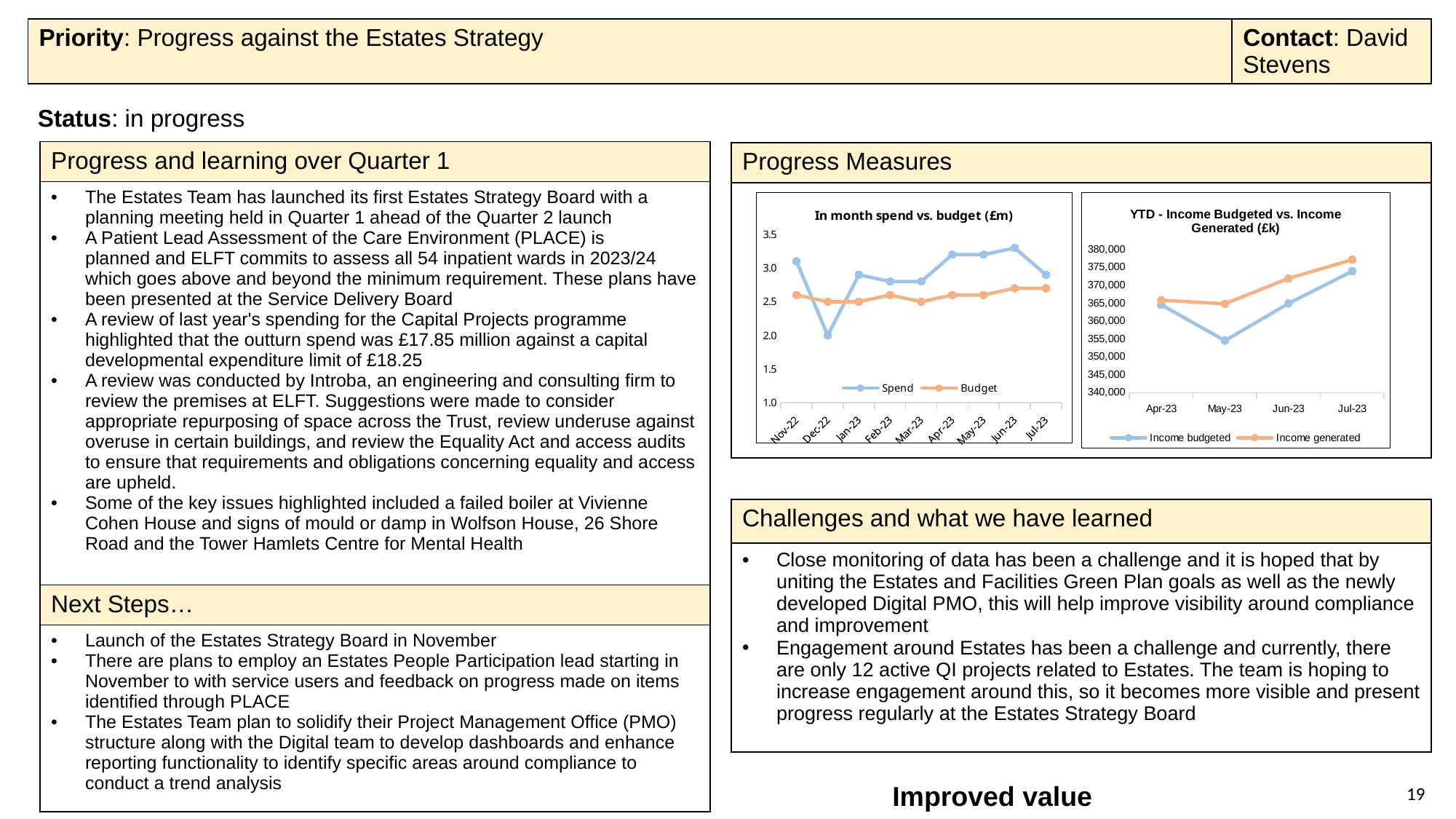
In the 'YTD - Income Budgeted vs. Income Generated (£k)' chart, is the Income budgeted value for May-23 greater or less than 360,000? less What are the two legend entries in the 'YTD - Income Budgeted vs. Income Generated (£k)' chart? Income budgeted and Income generated In the 'YTD - Income Budgeted vs. Income Generated (£k)' chart, which is larger in Jul-23, Income budgeted or Income generated? Income generated In the 'YTD - Income Budgeted vs. Income Generated (£k)' chart, how many months are plotted? 4 In the 'In month spend vs. budget (£m)' chart, which month has the lowest Spend value? Dec-22 In the 'In month spend vs. budget (£m)' chart, is the Spend value for Jun-23 greater or less than 3.0? greater In the 'In month spend vs. budget (£m)' chart, how many series does the legend list? 2 What kind of chart is the 'In month spend vs. budget (£m)' chart? line chart In the 'YTD - Income Budgeted vs. Income Generated (£k)' chart, which month has the lowest Income budgeted value? May-23 In the 'In month spend vs. budget (£m)' chart, is the Spend value for Dec-22 greater or less than 2.5? less In the 'In month spend vs. budget (£m)' chart, which is larger in Dec-22, Spend or Budget? Budget In the 'In month spend vs. budget (£m)' chart, how many months are plotted on the x axis? 9